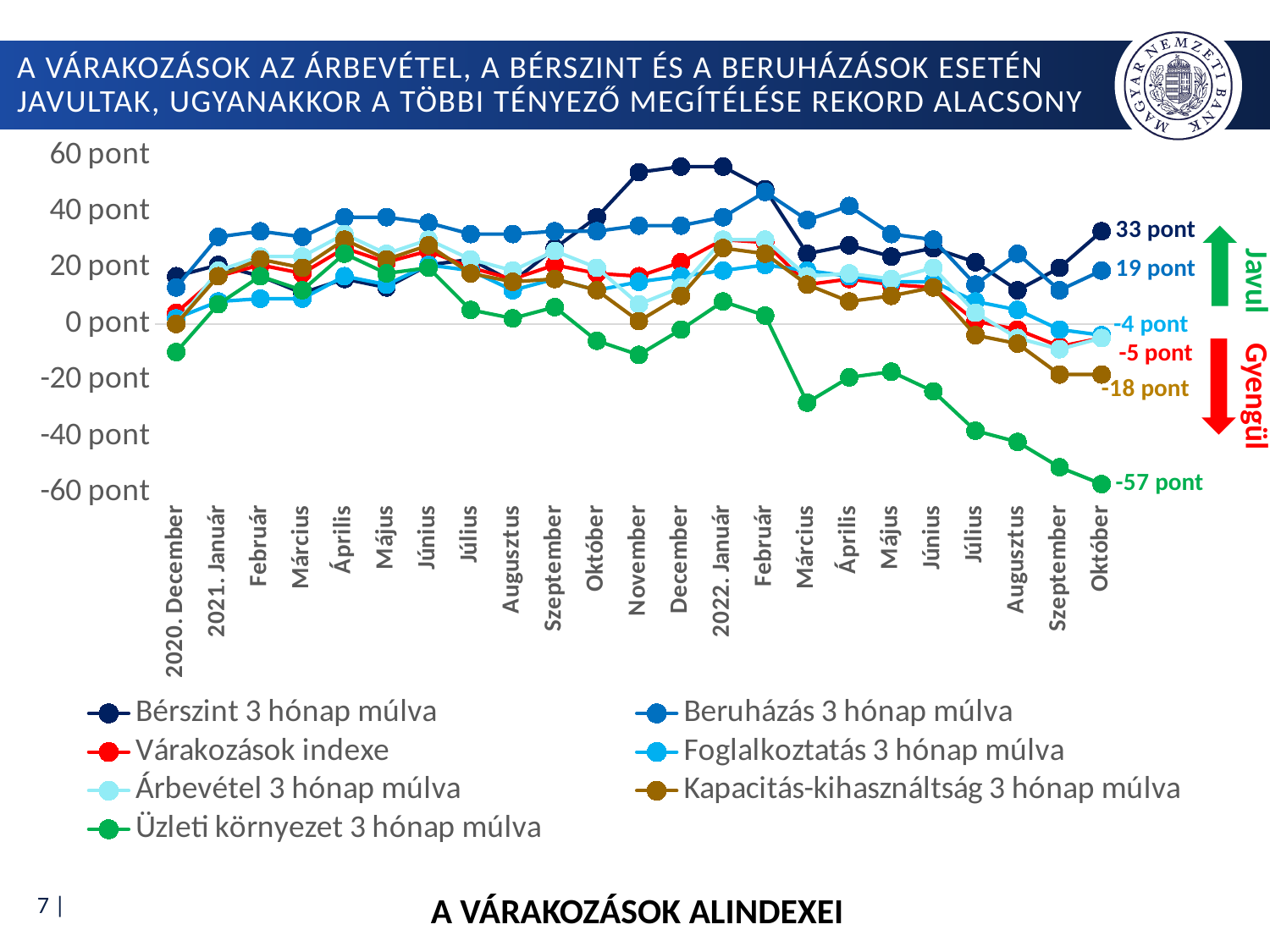
In 2022 Október, which is larger: Beruházás 3 hónap múlva or Kapacitás-kihasználtság 3 hónap múlva? Beruházás 3 hónap múlva What type of chart is shown on the slide? line chart What is the value of Bérszint 3 hónap múlva in 2022 Október? 33 pont Which series has the highest value in 2022 Október? Bérszint 3 hónap múlva How many months are shown on the x axis? 23 Which series has the lowest value in 2022 Október? Üzleti környezet 3 hónap múlva Is the value for Üzleti környezet 3 hónap múlva in 2022 Március greater or less than -20 pont? less What is the value of Beruházás 3 hónap múlva in 2022 Október? 19 pont What is the difference between Bérszint 3 hónap múlva and Üzleti környezet 3 hónap múlva in 2022 Október? 90 pont How many series does the legend list? 7 What is the value of Kapacitás-kihasználtság 3 hónap múlva in 2022 Október? -18 pont What is the value of Üzleti környezet 3 hónap múlva in 2022 Október? -57 pont